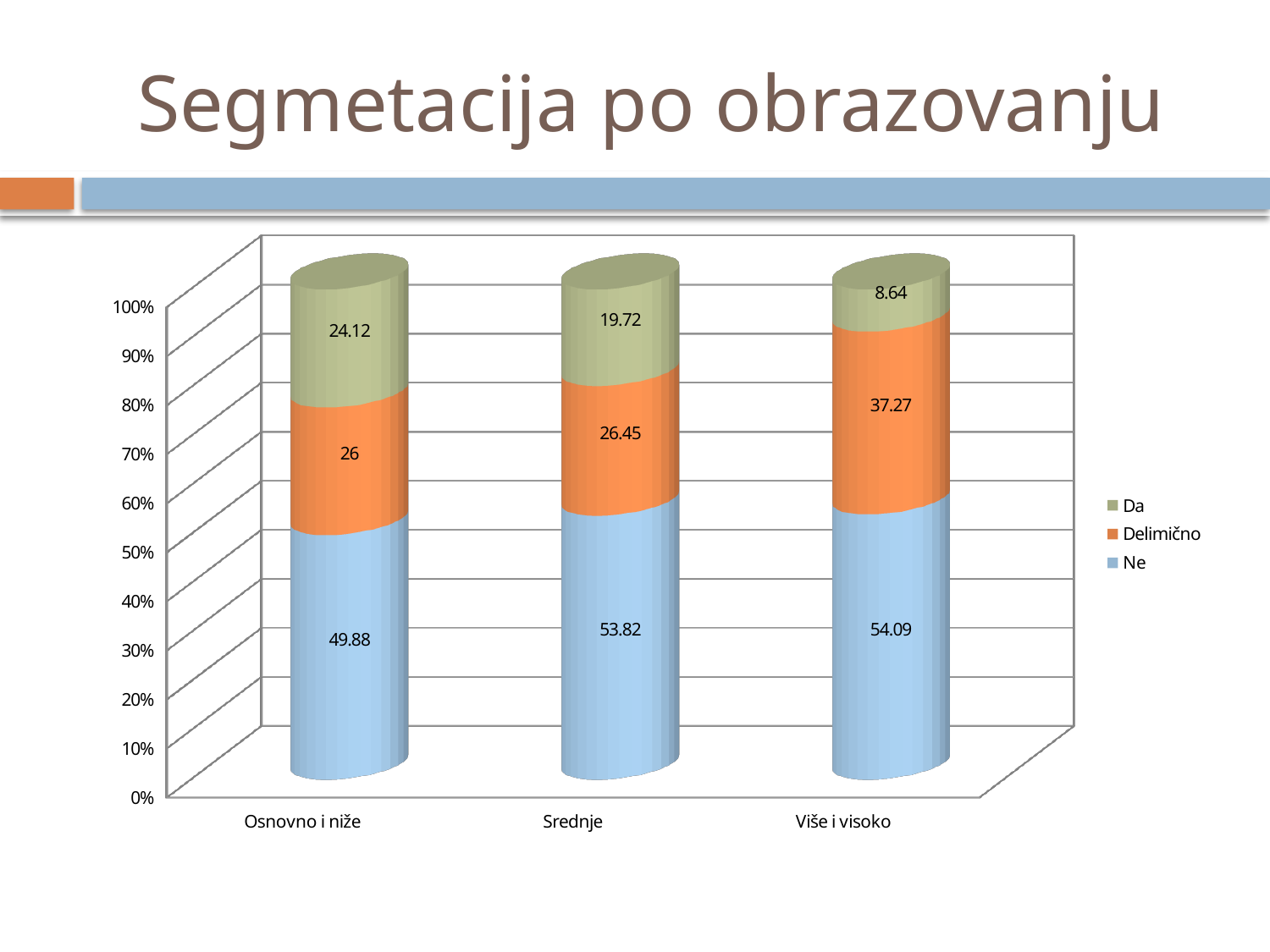
Which category has the highest value for "Da"? Osnovno i niže How many categories are shown on the x axis? 3 What is the value for "Da" in the "Više i visoko" category? 8.64 What is the title of the slide? Segmetacija po obrazovanju What is the difference between the "Delimično" values for "Više i visoko" and "Srednje"? 10.82 What is the value for "Ne" in the "Srednje" category? 53.82 Which series is shown in orange? Delimično What is the value for "Delimično" in the "Osnovno i niže" category? 26 How many series does the legend list? 3 Which is larger: the "Da" value for "Srednje" or the "Da" value for "Više i visoko"? Srednje Which category has the lowest value for "Ne"? Osnovno i niže What kind of chart is shown on the slide? Stacked bar chart